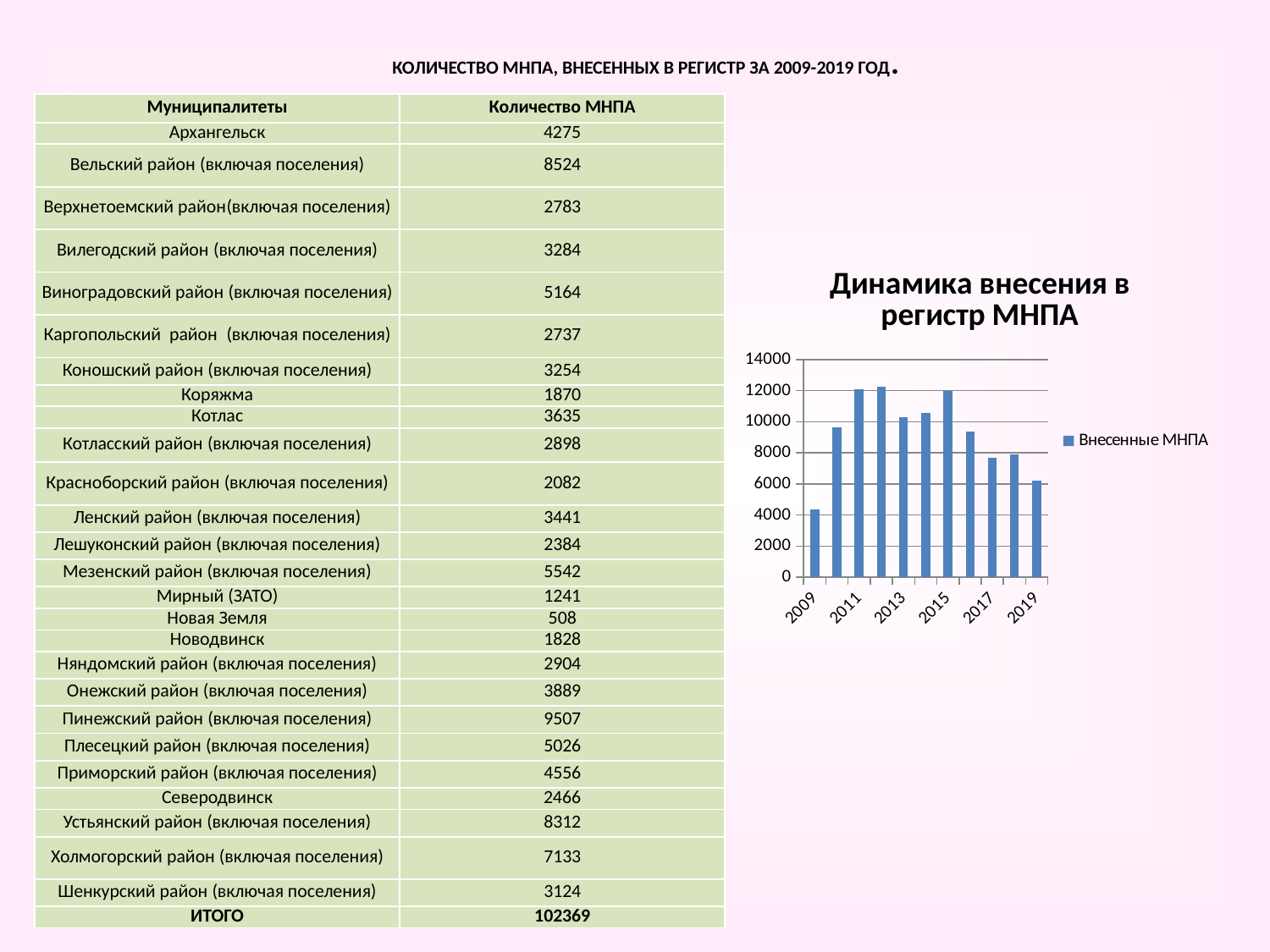
What kind of chart is "Динамика внесения в регистр МНПА"? bar chart In the chart "Динамика внесения в регистр МНПА", is the value for 2015 greater or less than 10000? greater In the chart "Динамика внесения в регистр МНПА", is the value for 2017 greater or less than 10000? less In the chart "Динамика внесения в регистр МНПА", which is larger, the value for 2011 or the value for 2009? 2011 In the chart "Динамика внесения в регистр МНПА", is the value for 2019 greater or less than 4000? greater In the chart "Динамика внесения в регистр МНПА", which year has the lowest value? 2009 How many bars are plotted in the chart "Динамика внесения в регистр МНПА"? 11 What is the legend entry of the chart "Динамика внесения в регистр МНПА"? Внесенные МНПА In the chart "Динамика внесения в регистр МНПА", do the values rise or fall from 2015 to 2019? fall In the chart "Динамика внесения в регистр МНПА", which is larger, the value for 2015 or the value for 2019? 2015 How many series does the legend of the chart "Динамика внесения в регистр МНПА" list? 1